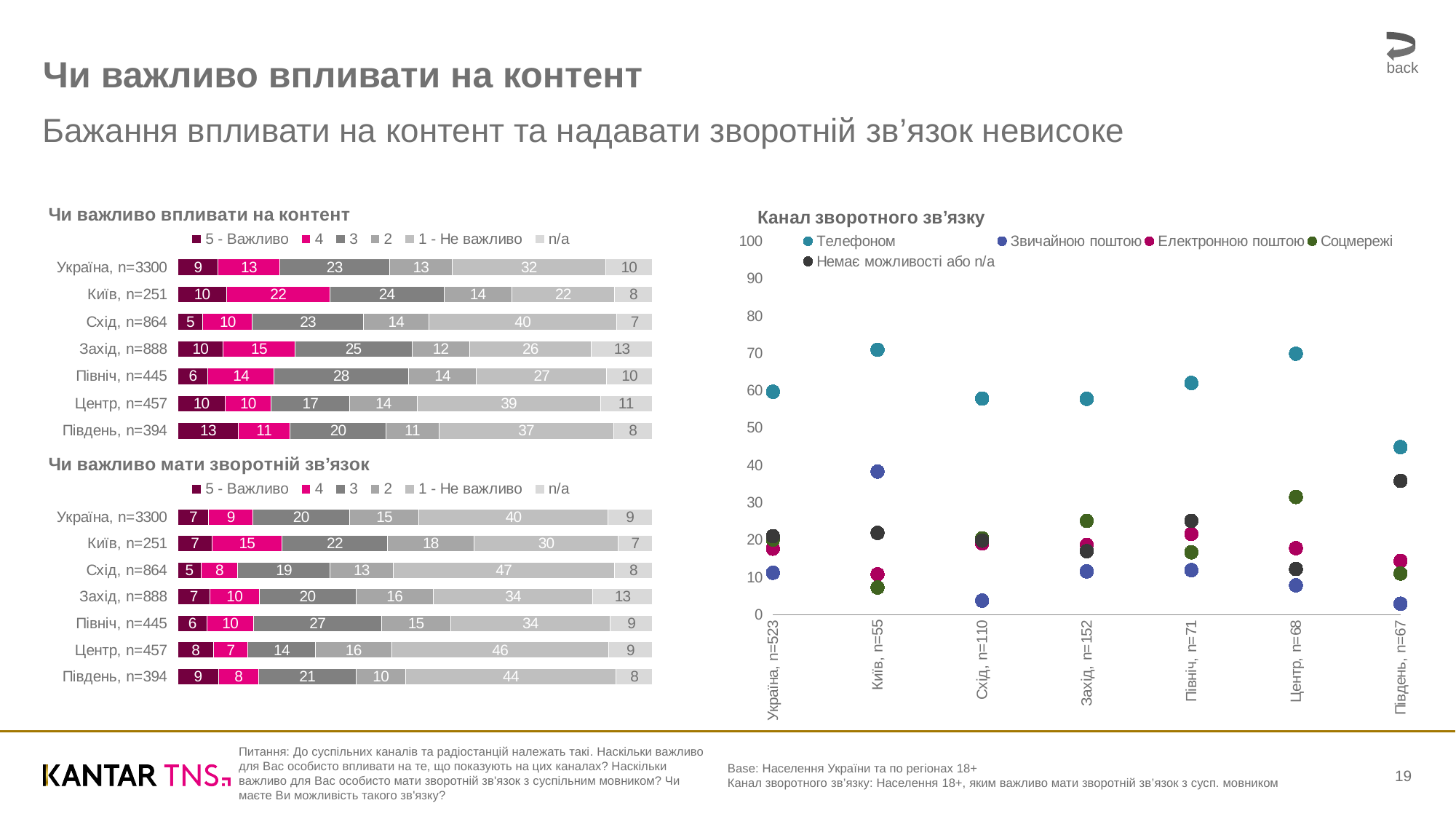
In the chart 'Канал зворотного зв'язку', is the value of 'Телефоном' for 'Київ, n=55' greater or less than 60? greater In the chart 'Чи важливо впливати на контент', which region has the highest value for '4'? Київ, n=251 In the chart 'Чи важливо мати зворотній зв'язок', what is the value of '1 - Не важливо' for 'Схід, n=864'? 47 In the chart 'Чи важливо впливати на контент', what is the value of '5 - Важливо' for 'Південь, n=394'? 13 In the chart 'Канал зворотного зв'язку', is the value of 'Звичайною поштою' for 'Схід, n=110' greater or less than 10? less In the chart 'Чи важливо впливати на контент', what is the difference between the '3' values for 'Північ, n=445' and 'Центр, n=457'? 11 In the chart 'Чи важливо мати зворотній зв'язок', how many series does the legend list? 6 What kind of chart is 'Чи важливо впливати на контент'? Stacked bar chart In the chart 'Чи важливо мати зворотній зв'язок', is the '2' value larger for 'Київ, n=251' or for 'Південь, n=394'? Київ, n=251 In the chart 'Канал зворотного зв'язку', how many series does the legend list? 5 In the chart 'Чи важливо мати зворотній зв'язок', which region has the lowest value for '5 - Важливо'? Схід, n=864 In the chart 'Чи важливо впливати на контент', what is the value of '1 - Не важливо' for 'Схід, n=864'? 40